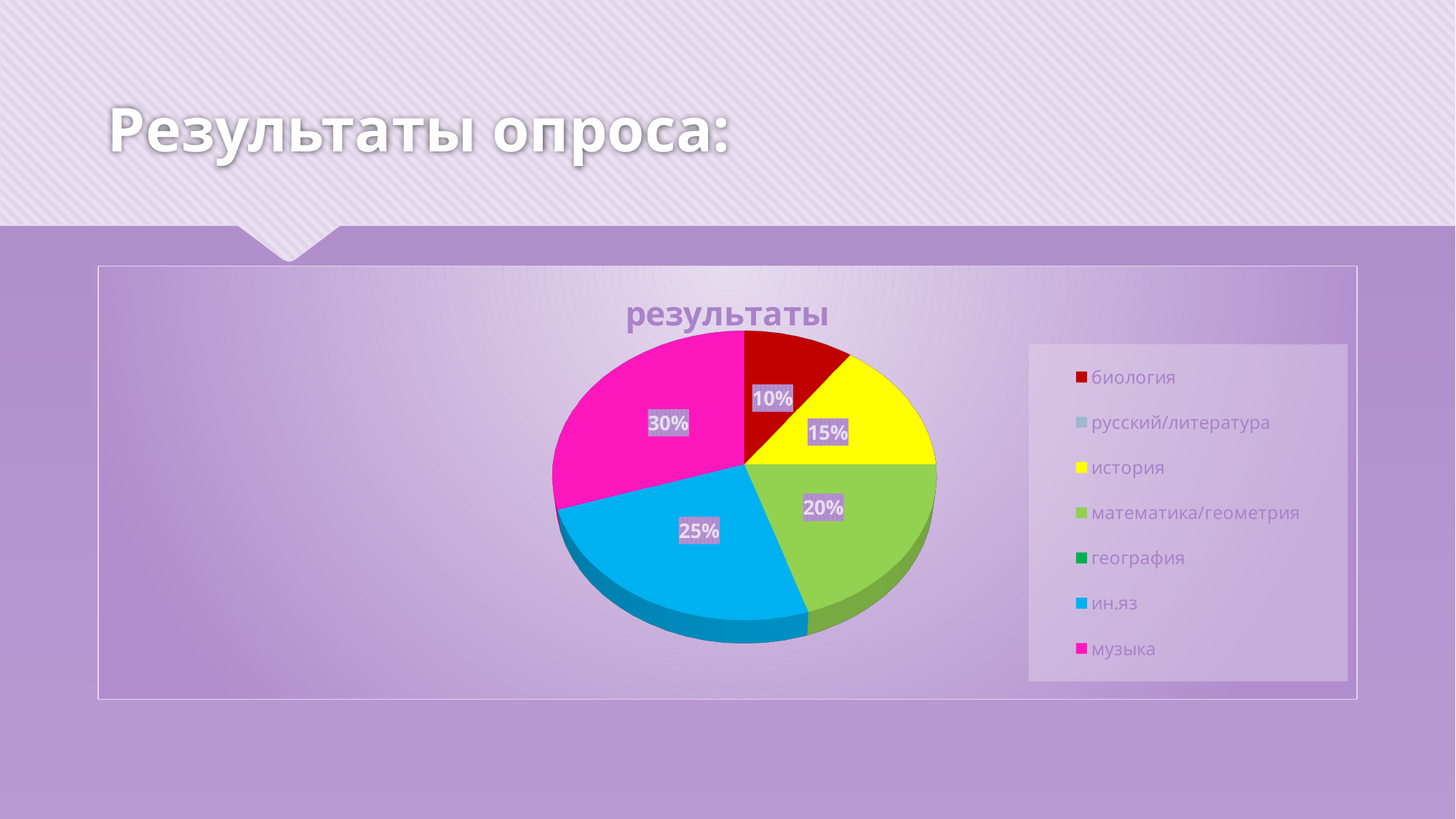
What is the title of the chart? результаты Which is larger, the slice for ин.яз or the slice for математика/геометрия? ин.яз What percentage does математика/геометрия account for? 20% Which of the labelled slices is the smallest? биология How many entries does the legend list? 7 What percentage is shown for биология? 10% What is the difference in percentage points between музыка and история? 15 Which category has the largest slice of the pie? музыка What type of chart is shown on the slide? pie chart How many slices with percentage labels are visible in the pie? 5 What share of the pie does музыка have? 30% What value is labelled on the ин.яз slice? 25%